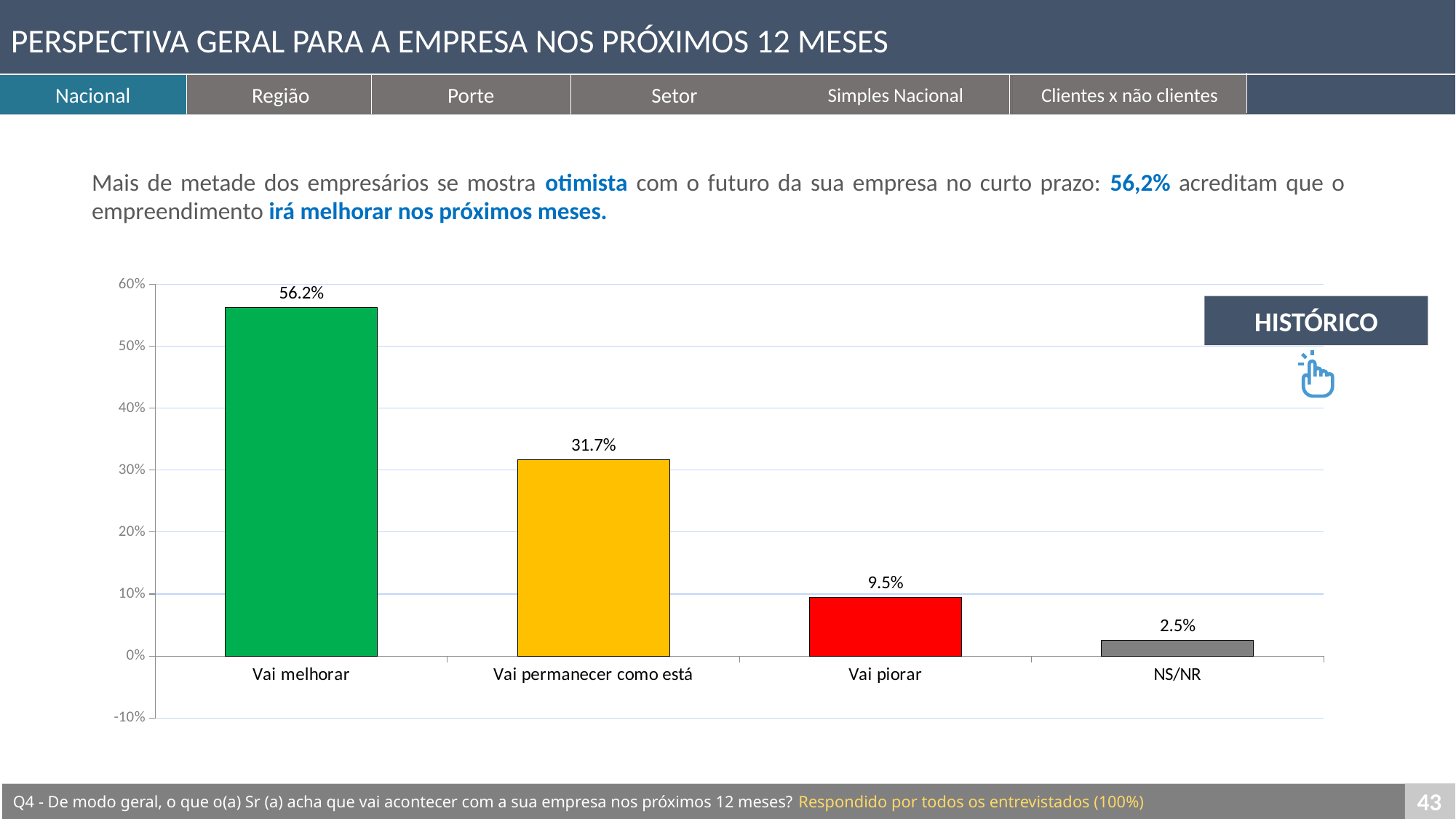
Which category has the lowest value? NS/NR How many categories are shown in the chart? 4 What is the value for "Vai piorar"? 9.5% What is the value for "Vai permanecer como está"? 31.7% What is the value for "Vai melhorar"? 56.2% What is the difference between the values for "Vai melhorar" and "Vai permanecer como está"? 24.5% Which is larger, the value for "Vai piorar" or the value for "NS/NR"? Vai piorar What is the difference between the values for "Vai piorar" and "NS/NR"? 7.0% What colour is the bar for "Vai piorar"? Red What is the value for "NS/NR"? 2.5% Which category has the highest value? Vai melhorar What kind of chart is shown on the slide? Bar chart